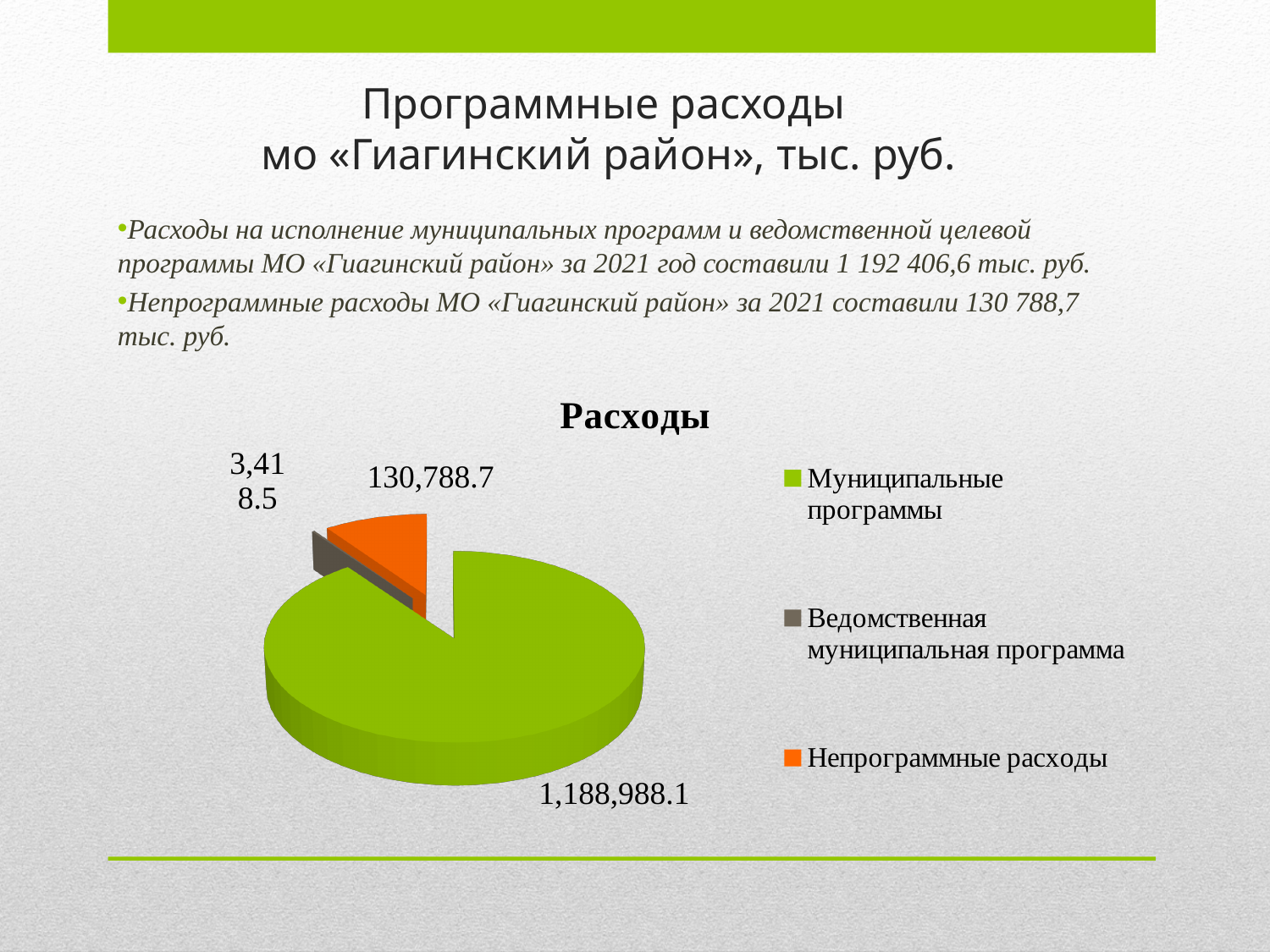
What type of chart is shown on the slide? pie chart What is the value for Муниципальные программы? 1,188,988.1 How many slices does the pie chart have? 3 Which category has the smallest slice of the pie? Ведомственная муниципальная программа Which is larger: Непрограммные расходы or Ведомственная муниципальная программа? Непрограммные расходы What is the value for Ведомственная муниципальная программа? 3,418.5 How many entries does the chart legend list? 3 What colour is the slice for Непрограммные расходы? orange What is the difference between Муниципальные программы and Непрограммные расходы? 1,058,199.4 What is the value for Непрограммные расходы? 130,788.7 What is the title of the chart? Расходы Which category has the largest slice of the pie? Муниципальные программы